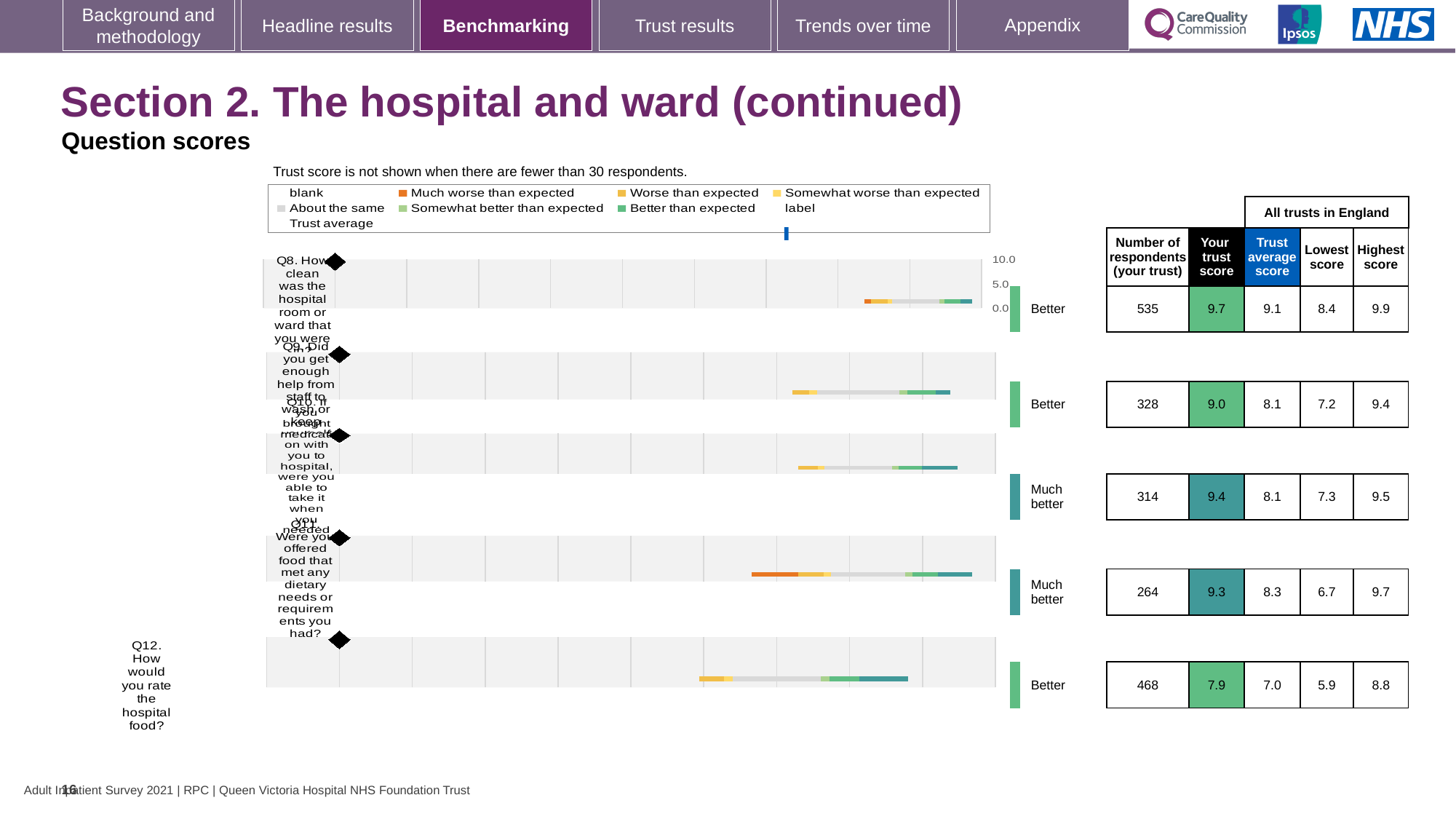
How many respondents are shown for Q12 (How would you rate the hospital food?)? 468 What kind of chart is used to show the question scores on this slide? Bar chart What is the 'Your trust score' for Q8 (How clean was the hospital room or ward that you were in?)? 9.7 What benchmark rating label is shown for Q11 (Were you offered food that met any dietary needs or requirements you had?)? Much better Which has the higher 'Your trust score', Q9 or Q10? Q10 Which question has the highest 'Your trust score'? Q8 What is the 'Highest score' across all trusts in England for Q10? 9.5 Which question has the lowest 'Your trust score'? Q12 According to the note above the chart, when is the trust score not shown? When there are fewer than 30 respondents For Q8, what is the difference between 'Your trust score' and the 'Trust average score'? 0.6 How many questions (Q8 to Q12) are plotted in the question scores chart? 5 How many of the questions are rated 'Much better'? 2